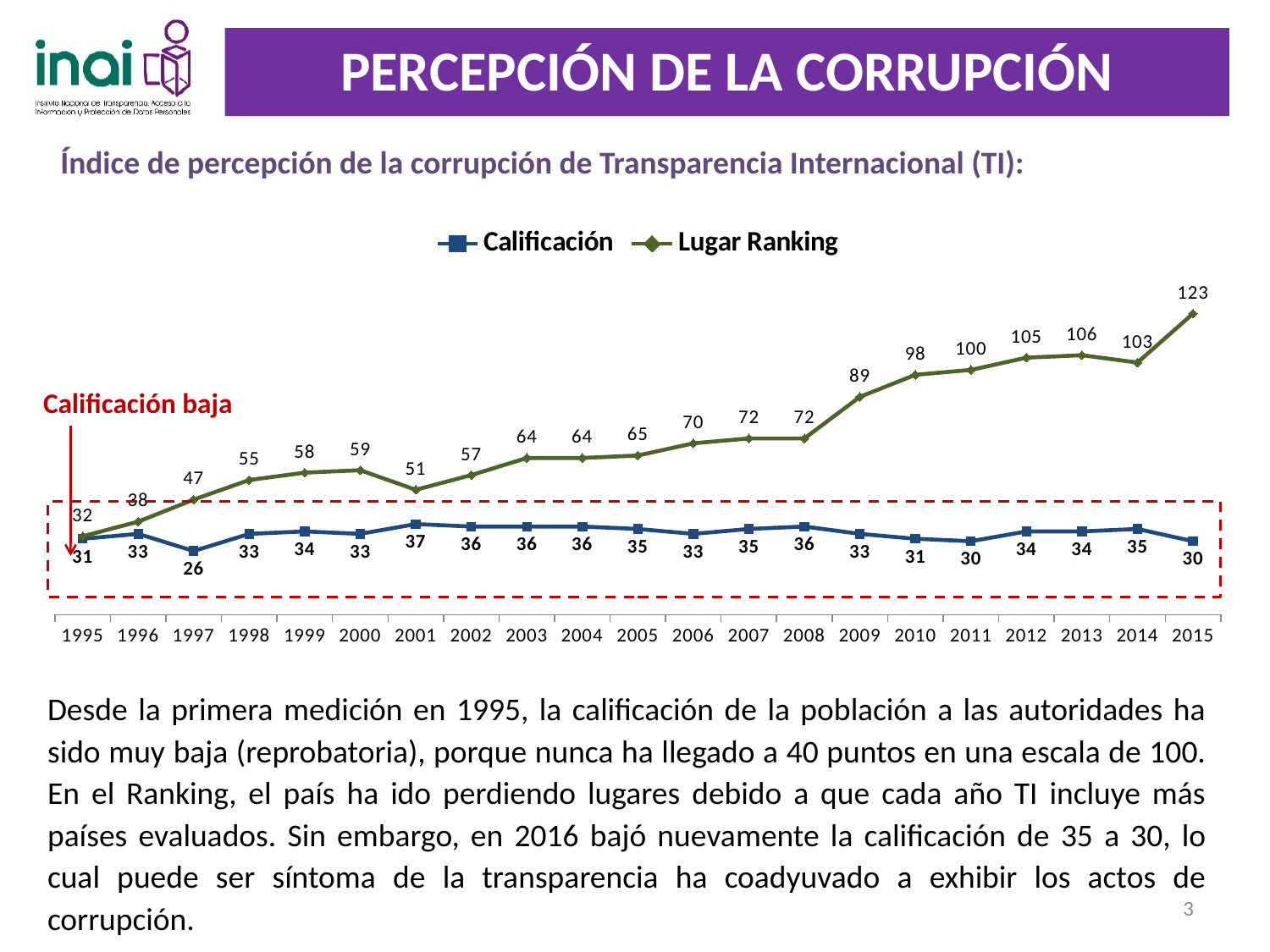
What is the Lugar Ranking value for 2009? 89 How many years are shown on the x axis? 21 What is the difference between the Lugar Ranking values for 2015 and 2014? 20 How many series does the legend list? 2 What is the difference between the Calificación values for 2001 and 1997? 11 Which is larger, the Lugar Ranking value for 2001 or for 2002? 2002 What is the Lugar Ranking value for 2015? 123 What kind of chart is shown on the slide? Line chart In which year is the Lugar Ranking series lowest? 1995 Does the Lugar Ranking series generally rise or fall from 1995 to 2015? Rise What is the Calificación value for 1997? 26 In which year is the Calificación series highest? 2001